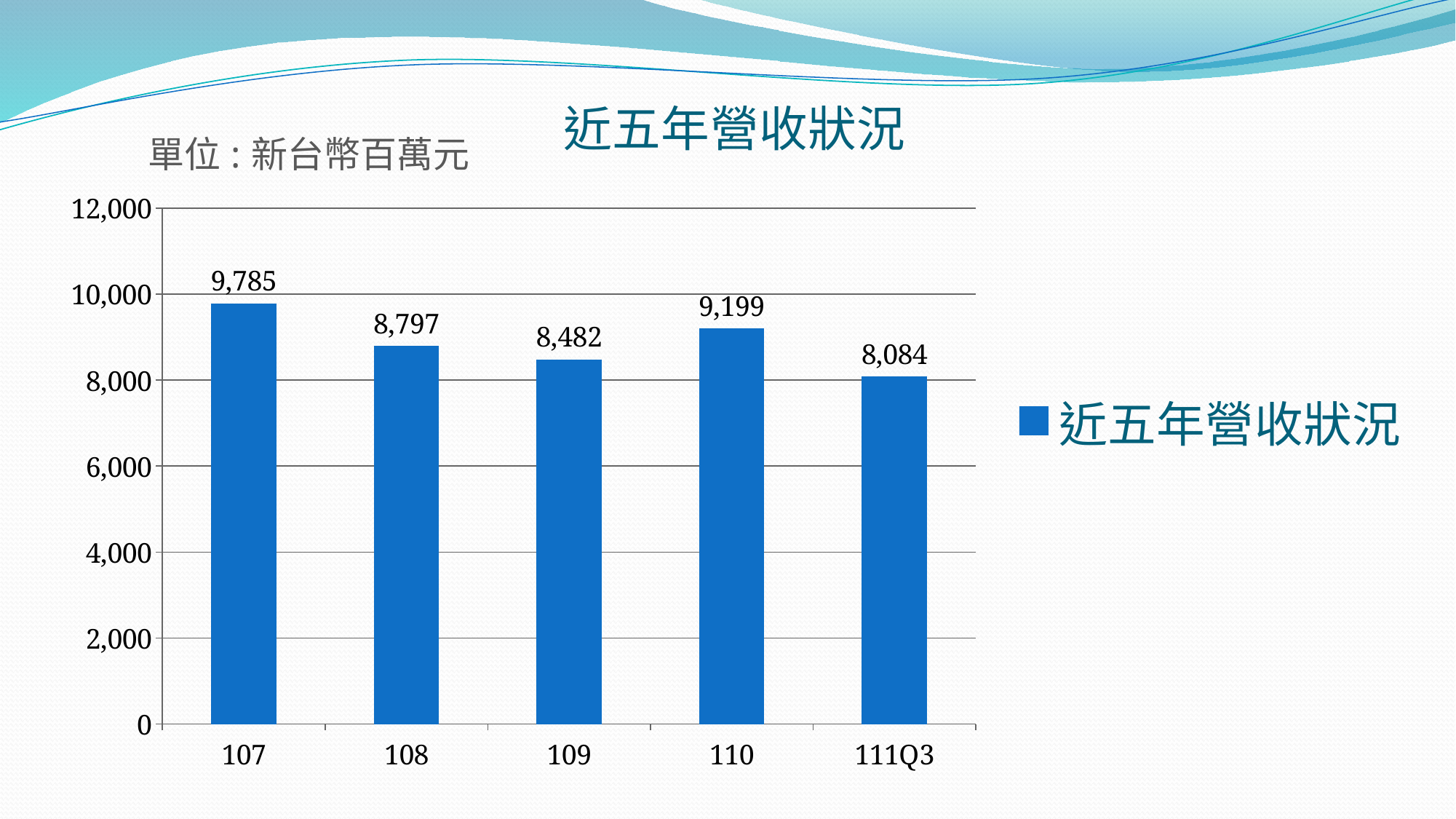
Which category has the highest value? 107 What is the title of the chart? 近五年營收狀況 Which is larger, the value for 108 or the value for 110? 110 Which category has the lowest value? 111Q3 What is the difference between the values for 110 and 111Q3? 1,115 Is the value for 109 greater or less than 10,000? less What is the value for 107? 9,785 How many categories are shown on the x axis? 5 What is the difference between the values for 107 and 108? 988 What is the value for 109? 8,482 What is the value for 111Q3? 8,084 What kind of chart is shown on the slide? bar chart